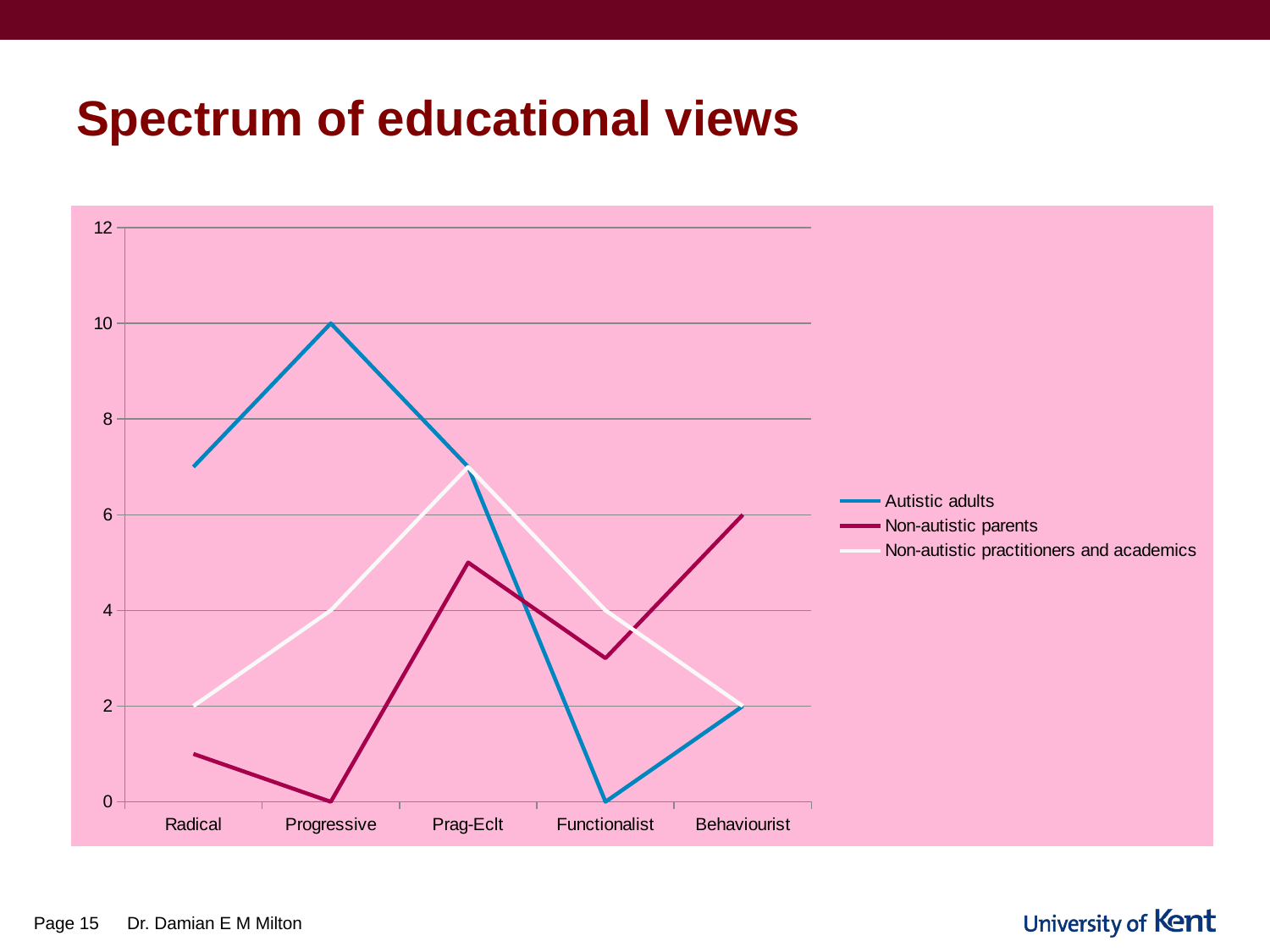
What is the value for Autistic adults at Progressive? 10 What kind of chart is shown on the slide? line chart At which category is the Autistic adults line highest? Progressive At which category is the Non-autistic parents line lowest? Progressive Does the Non-autistic parents line rise or fall from Functionalist to Behaviourist? rise Which series has the larger value at Behaviourist, Non-autistic parents or Autistic adults? Non-autistic parents What is the value for Autistic adults at Functionalist? 0 What is the value for Non-autistic parents at Behaviourist? 6 What is the value for Non-autistic practitioners and academics at Radical? 2 How many categories are shown on the x axis? 5 How many series does the legend list? 3 Is the value for Autistic adults at Radical greater or less than 6? greater